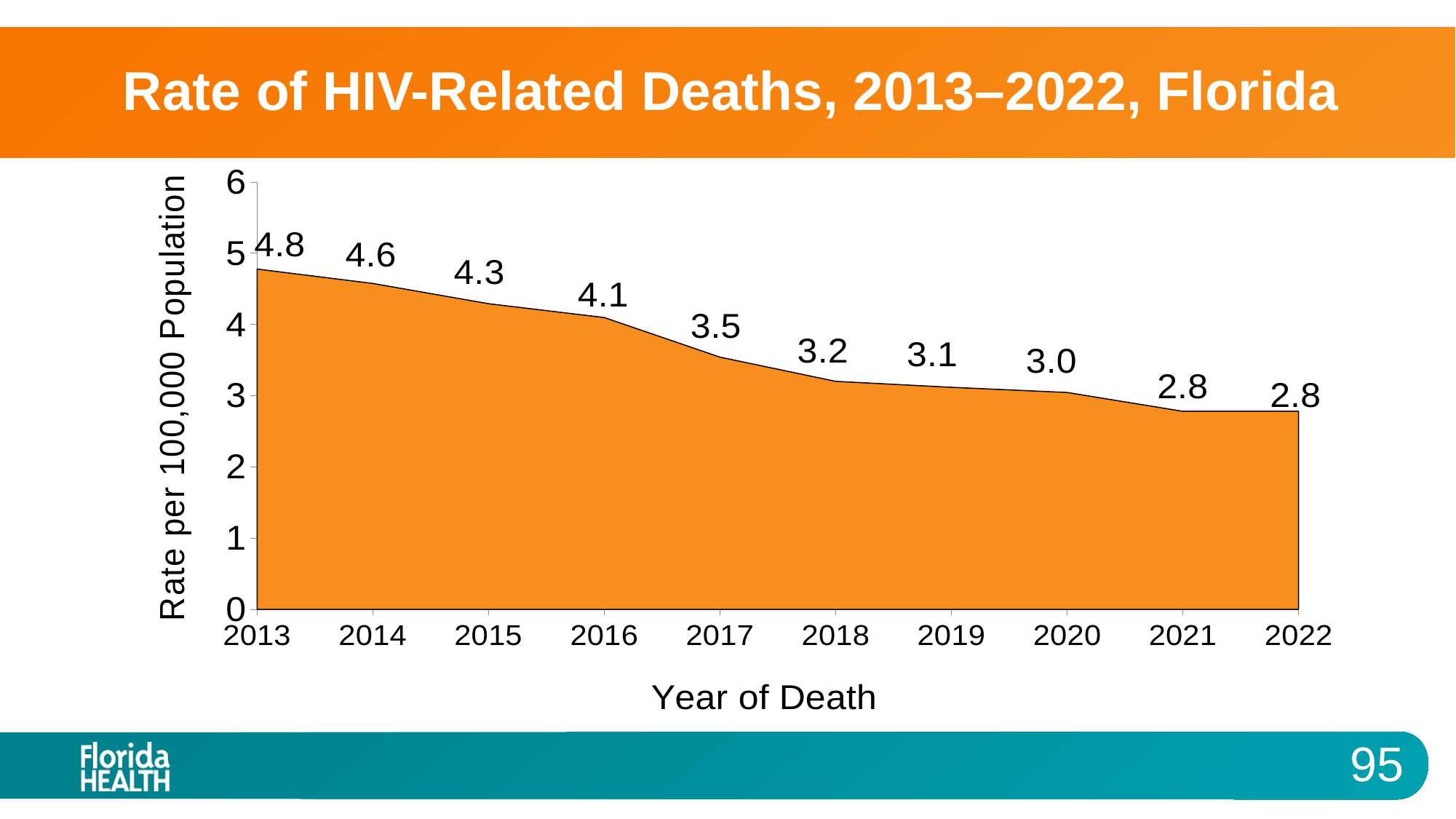
What was the rate of HIV-related deaths per 100,000 population in 2022? 2.8 Which year had the highest rate of HIV-related deaths? 2013 What is the difference between the rate of HIV-related deaths in 2013 and in 2022? 2.0 What is the difference between the rate in 2016 and the rate in 2017? 0.6 What was the rate of HIV-related deaths per 100,000 population in Florida in 2013? 4.8 What is the lowest rate of HIV-related deaths shown on the chart? 2.8 Does the rate of HIV-related deaths rise or fall from 2013 to 2022? Fall How many years are plotted on the chart? 10 What is the label of the x axis? Year of Death What kind of chart is shown on the slide? Area chart Which year had a higher rate of HIV-related deaths, 2015 or 2019? 2015 What was the rate of HIV-related deaths per 100,000 population in 2017? 3.5